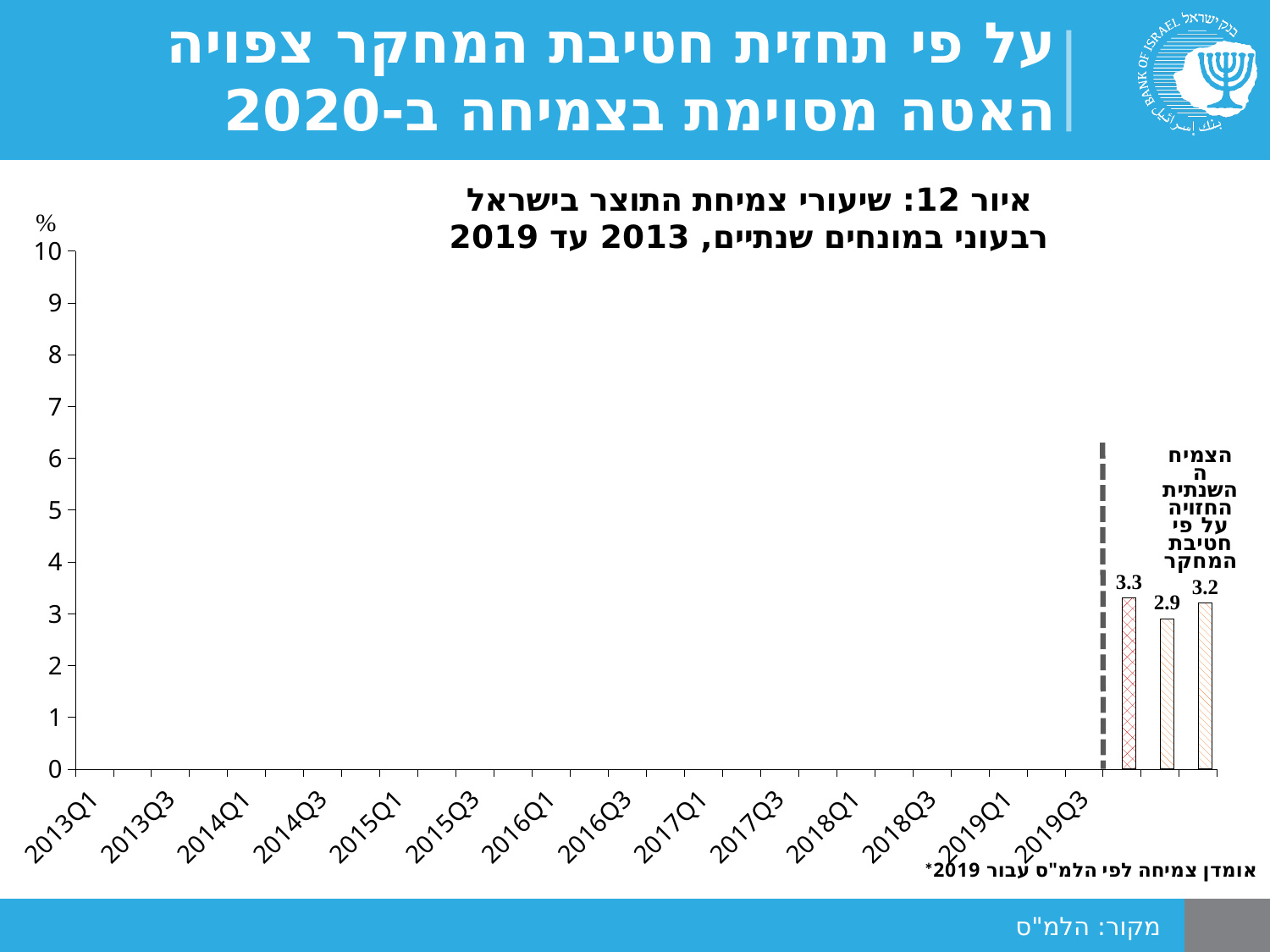
Which of the three labelled bars has the lowest value? the middle bar (2.9) What is the value printed on the leftmost of the three bars to the right of the dashed line? 3.3 What is the difference between the leftmost labelled bar (3.3) and the middle bar (2.9)? 0.4 Which of the three labelled bars has the highest value? the leftmost bar (3.3) What is the highest value shown on the vertical axis? 10 Is the value of the middle labelled bar greater or less than 3? less How many bars with printed data labels are shown in the chart? 3 What is the value printed on the rightmost bar in the chart? 3.2 What is the value printed on the middle of the three bars to the right of the dashed line? 2.9 Which is larger, the value of the rightmost bar or the value of the middle bar? the rightmost bar (3.2) What unit is shown at the top of the vertical axis? % What kind of chart is shown on the slide? bar chart